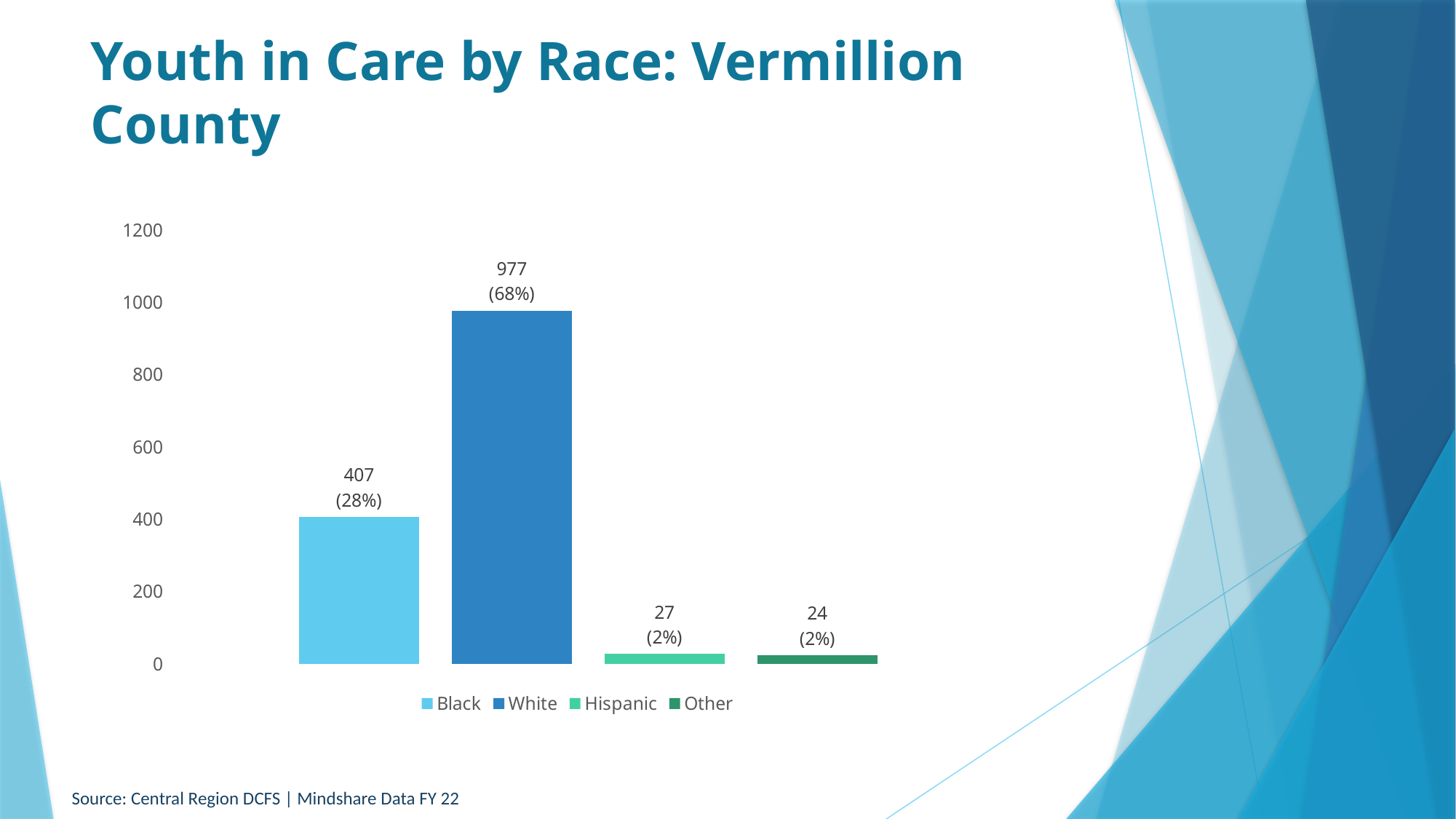
What is the number of youth in care for the Black category? 407 Which category has the highest number of youth in care? White How many categories are shown in the chart? 4 Which is larger, the value for Black or the value for Hispanic? Black What kind of chart is shown on the slide? Bar chart What is the difference between the White and Black values? 570 What is the number of youth in care for the Other category? 24 Which category has the lowest number of youth in care? Other What is the title of the slide? Youth in Care by Race: Vermillion County Is the value for White greater or less than 800? greater What percentage is shown for the Hispanic category? 2% What is the number of youth in care for the White category? 977